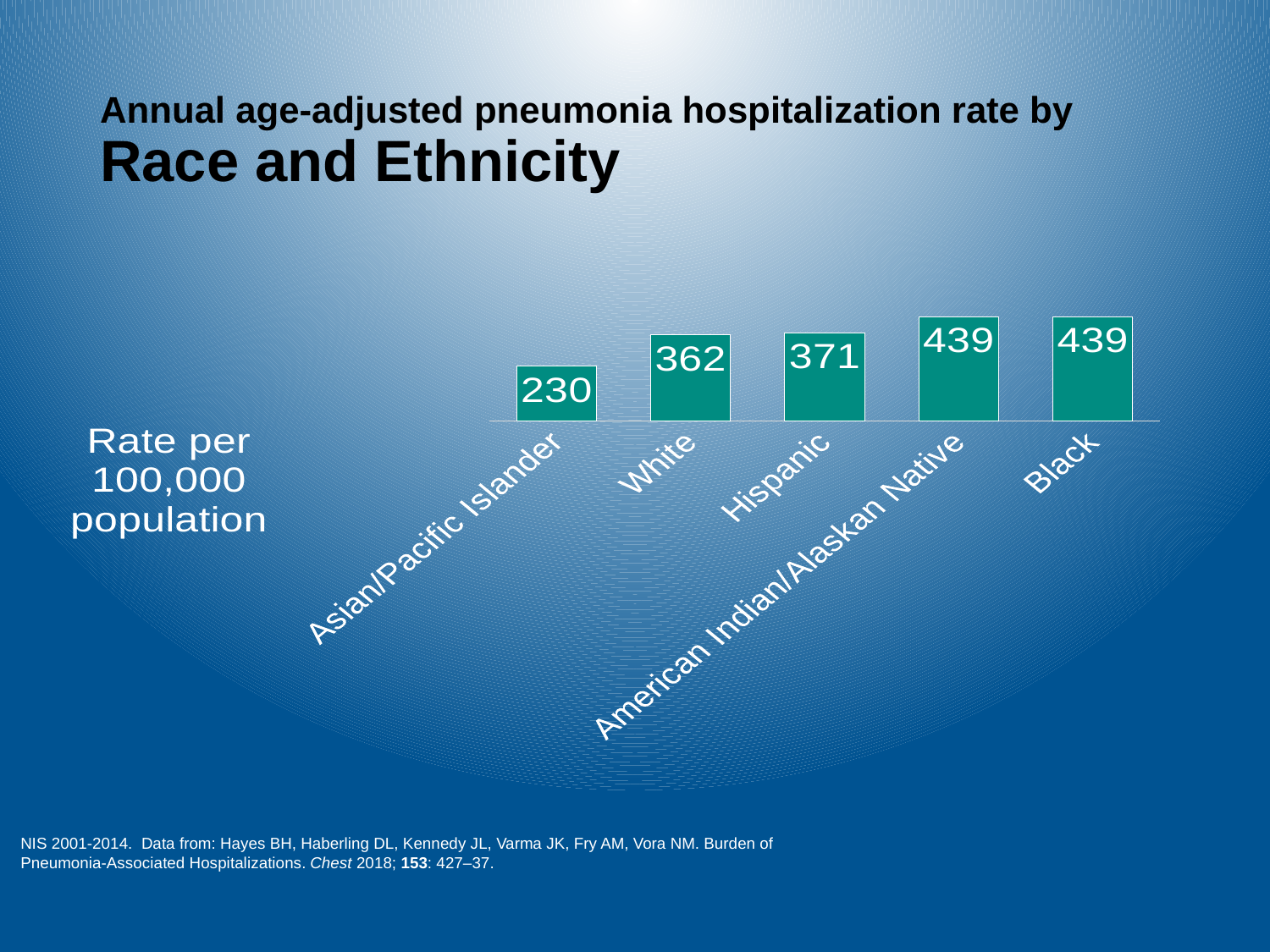
How many race/ethnicity categories are shown in the chart? 5 What is the difference between the rates for Black and Asian/Pacific Islander? 209 What is the difference between the rates for Hispanic and White? 9 What is the pneumonia hospitalization rate for American Indian/Alaskan Native? 439 What is the pneumonia hospitalization rate for Hispanic? 371 Which has a higher rate, White or Asian/Pacific Islander? White What kind of chart is shown on the slide? Bar chart Which race/ethnicity group has the lowest pneumonia hospitalization rate? Asian/Pacific Islander What unit is the rate expressed in, according to the axis label? Rate per 100,000 population What is the pneumonia hospitalization rate for White? 362 What is the pneumonia hospitalization rate for Asian/Pacific Islander? 230 What is the pneumonia hospitalization rate for Black? 439